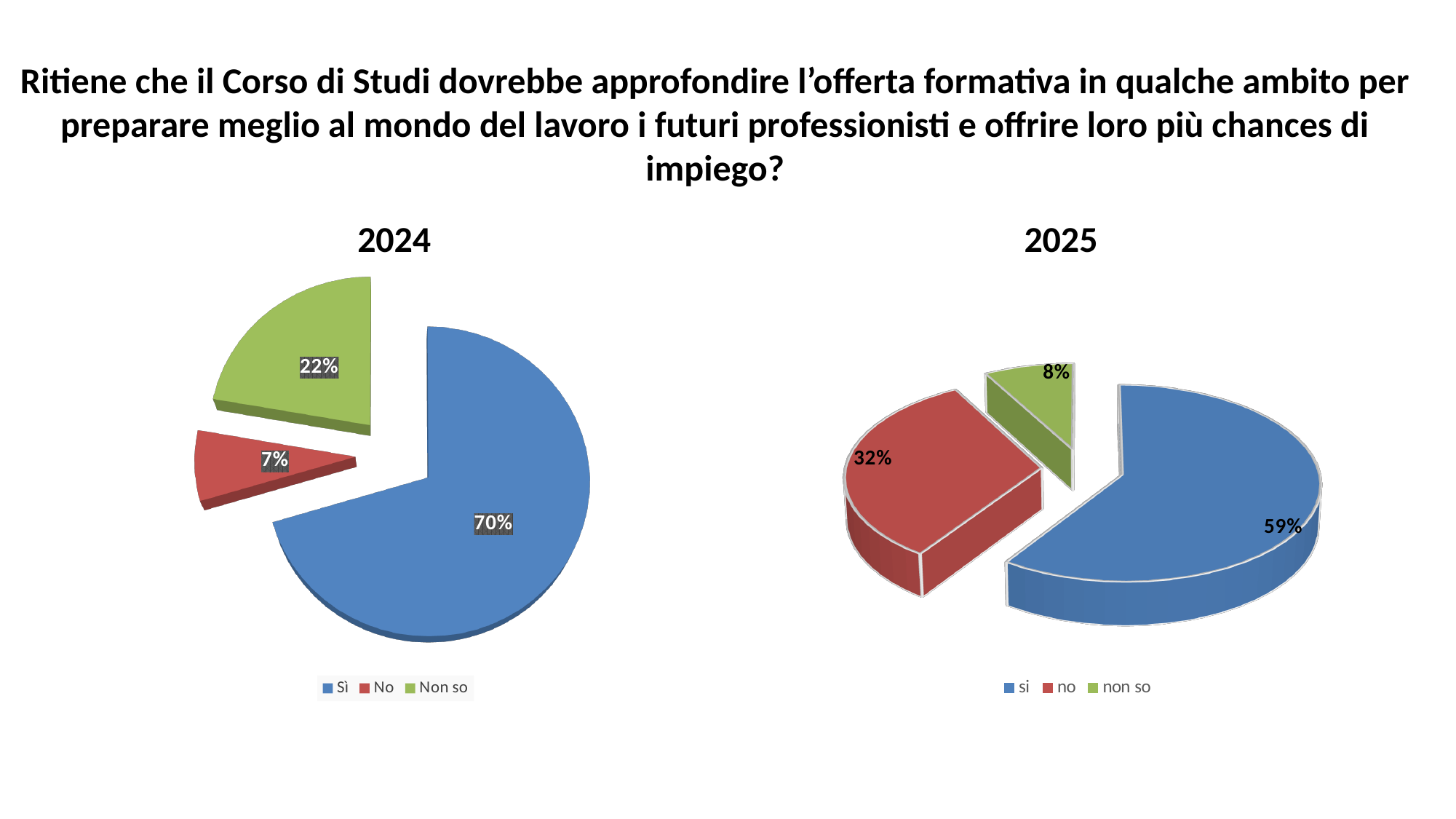
In the 2025 pie chart, which response has the smallest share? non so What type of chart is used for the 2025 data? Pie chart In the 2024 pie chart, which response has the largest share? Sì In the 2024 pie chart, what percentage of respondents answered "Non so"? 22% In the 2025 pie chart, what percentage of respondents answered "no"? 32% Which is larger: the "Sì" share in the 2024 chart or the "si" share in the 2025 chart? 2024 (70%) How many categories does the legend of the 2024 pie chart list? 3 In the 2025 pie chart, what percentage of respondents answered "non so"? 8% In the 2024 pie chart, what percentage of respondents answered "Sì"? 70% What is the difference between the "no" share in the 2025 chart and the "No" share in the 2024 chart? 25% In the 2025 pie chart, what percentage of respondents answered "si"? 59% In the 2024 pie chart, what percentage of respondents answered "No"? 7%